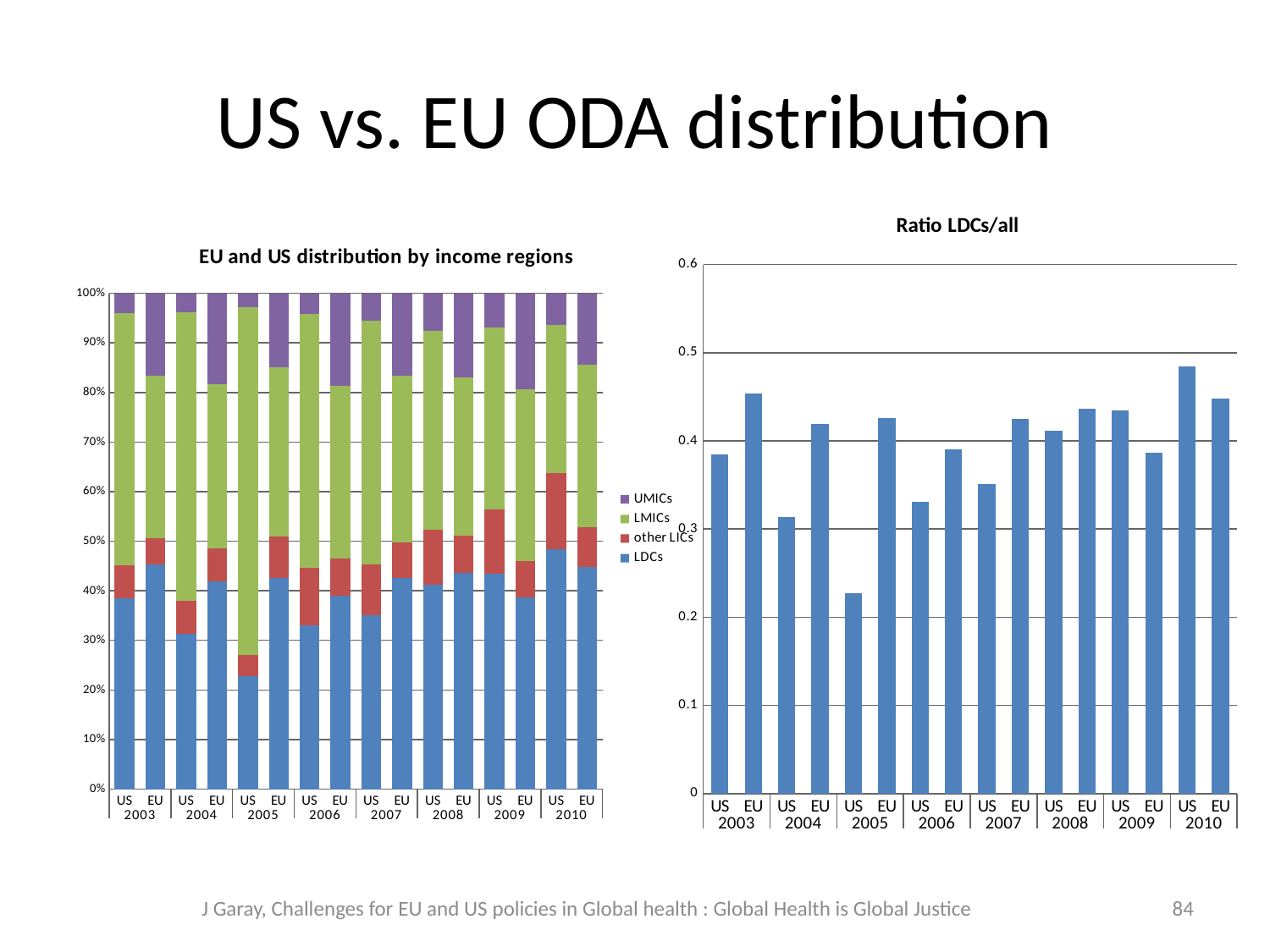
What type of chart is the 'EU and US distribution by income regions' chart? stacked bar chart In the 'Ratio LDCs/all' chart, is the value for US 2005 greater or less than 0.3? less How many bars are plotted in the 'Ratio LDCs/all' chart? 16 In the 'Ratio LDCs/all' chart, is the value for EU 2003 greater or less than 0.4? greater In the 'Ratio LDCs/all' chart, is the value for US 2007 greater or less than 0.4? less How many series does the legend of the 'EU and US distribution by income regions' chart list? 4 What type of chart is the 'Ratio LDCs/all' chart? bar chart In the 'EU and US distribution by income regions' chart, which series is shown in purple? UMICs In the 'Ratio LDCs/all' chart, which bar is the highest? US 2010 In the 'Ratio LDCs/all' chart, which is larger, the value for US 2005 or EU 2005? EU 2005 In the 'Ratio LDCs/all' chart, which bar is the lowest? US 2005